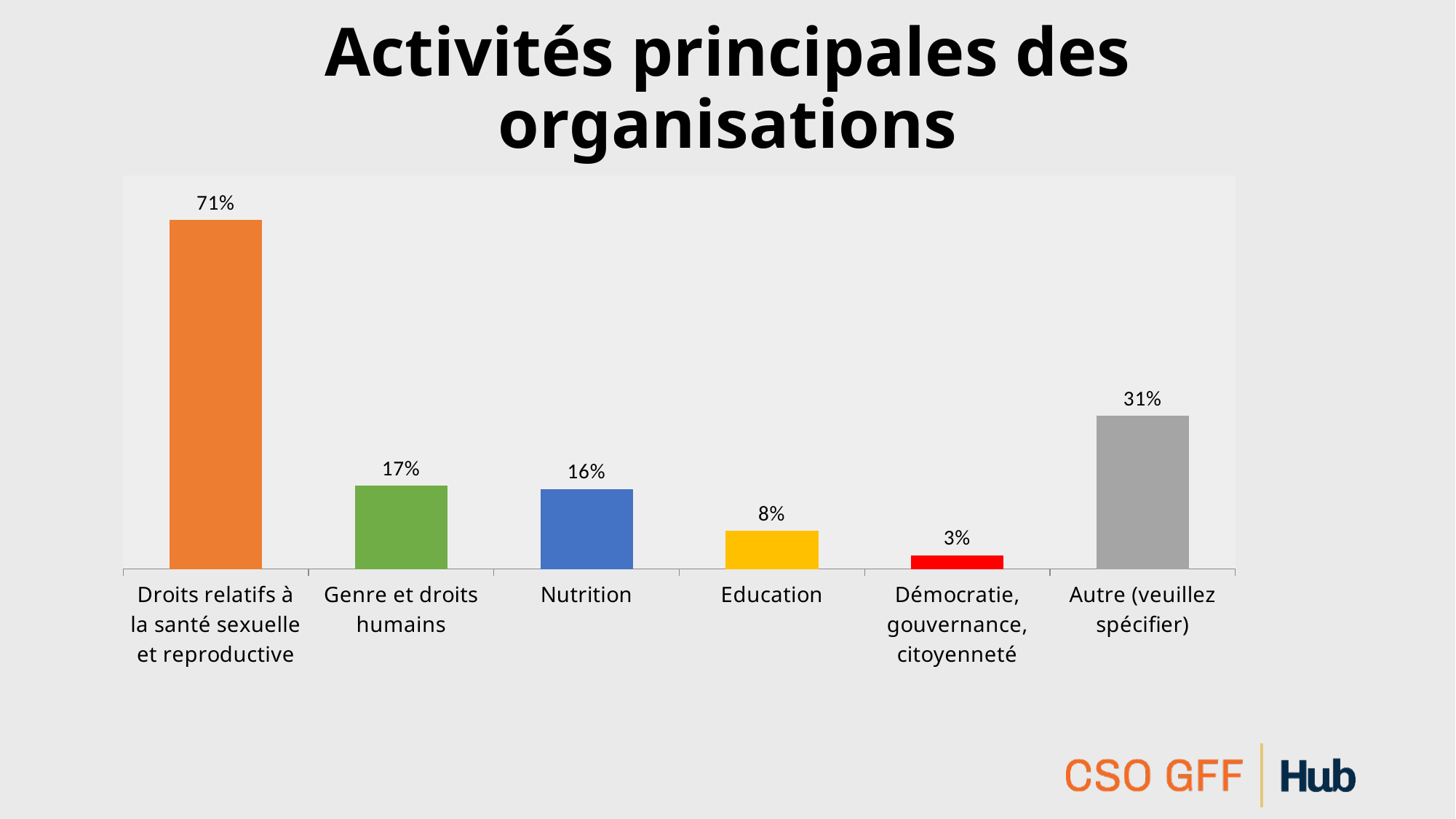
What is the difference between the values for Droits relatifs à la santé sexuelle et reproductive and Autre (veuillez spécifier)? 40% What is the value for Nutrition? 16% What kind of chart is shown on the slide? Bar chart Which category has the lowest value? Démocratie, gouvernance, citoyenneté Which is larger, the value for Autre (veuillez spécifier) or the value for Genre et droits humains? Autre (veuillez spécifier) What is the value for Education? 8% What is the difference between the values for Genre et droits humains and Education? 9% What is the value for Autre (veuillez spécifier)? 31% How many categories are shown in the chart? 6 What is the title of the chart? Activités principales des organisations Which category has the highest value? Droits relatifs à la santé sexuelle et reproductive What is the value for Démocratie, gouvernance, citoyenneté? 3%